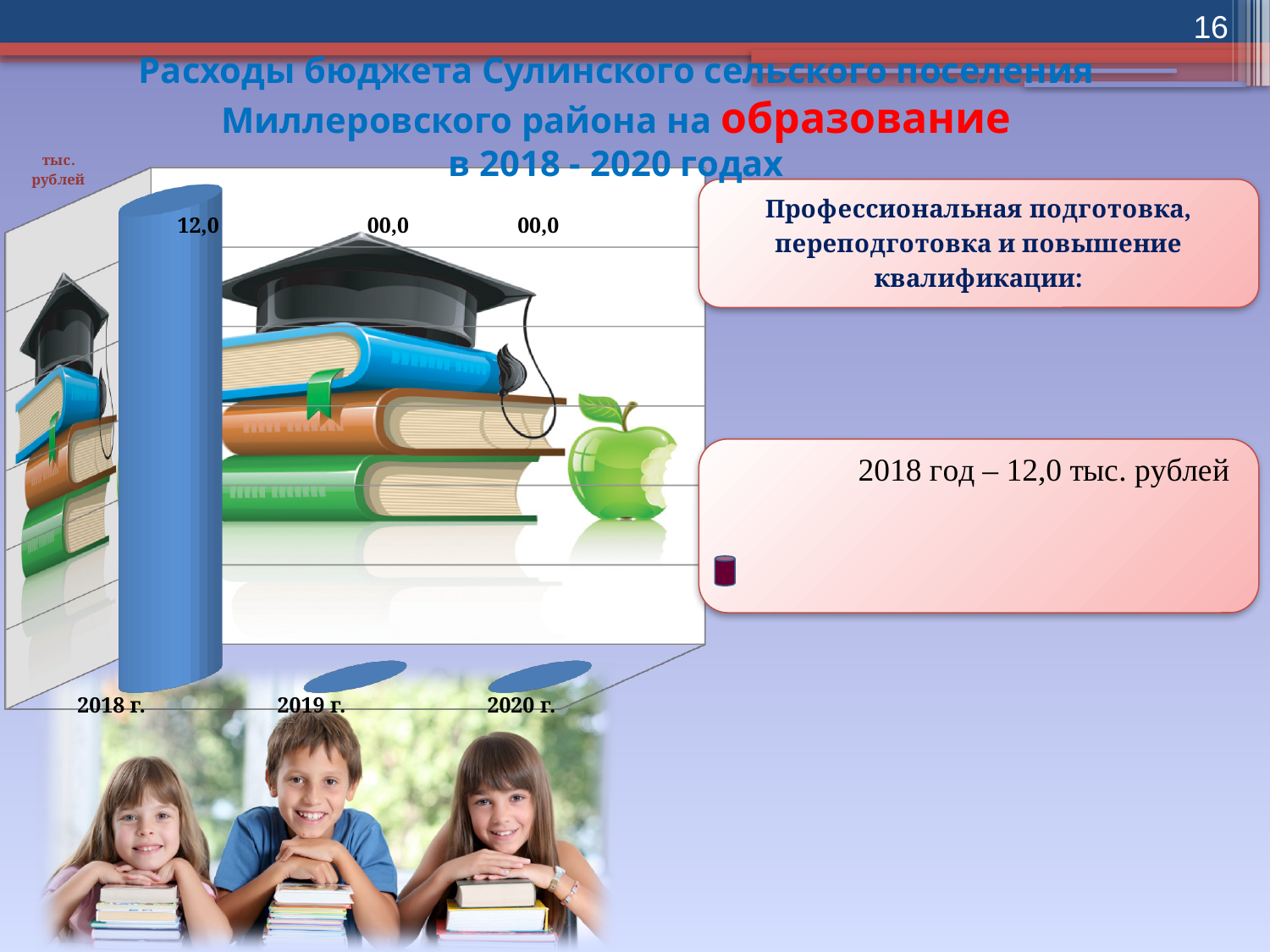
According to the slide title, which budget expenditure area does the chart cover? образование What is the difference between the values for 2018 г. and 2020 г.? 12,0 Do the values rise or fall from 2018 г. to 2020 г.? fall What kind of chart is shown on the slide? bar chart Which is larger, the value for 2018 г. or the value for 2019 г.? 2018 г. What unit is indicated at the top left of the chart? тыс. рублей What value is printed above the bar for 2019 г.? 00,0 What value is printed above the bar for 2020 г.? 00,0 Which year has the highest value in the chart? 2018 г. What is the value for 2018 г. in the chart? 12,0 How many categories (years) are shown on the x axis of the chart? 3